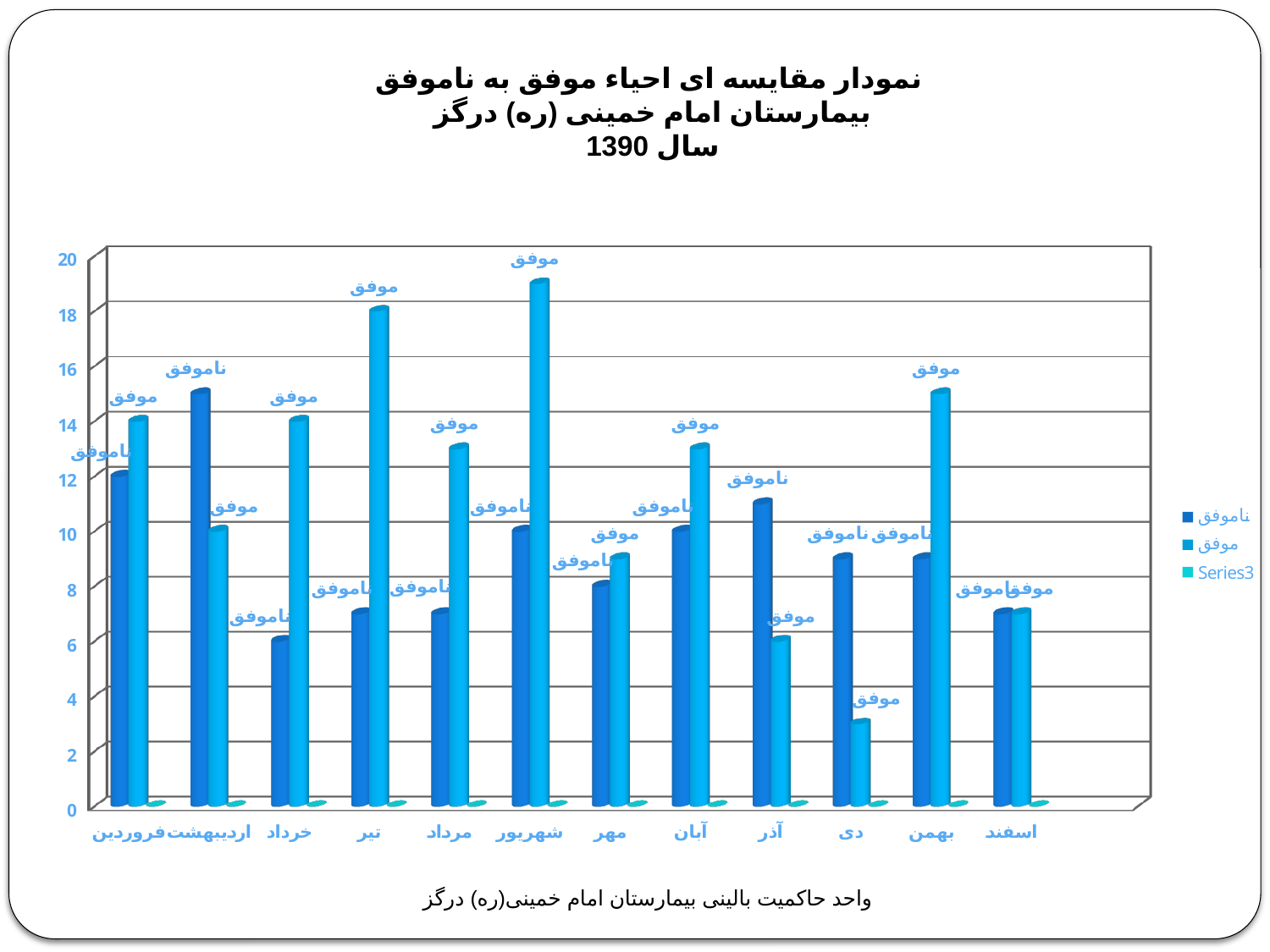
Is the ناموفق value for اردیبهشت greater or less than 14? greater What kind of chart is shown on the slide? bar chart How many series does the legend list? 3 Is the موفق value for شهریور greater or less than 18? greater Which month has the highest value for the ناموفق series? اردیبهشت In آذر, which series has the larger value, موفق or ناموفق? ناموفق How many months (categories) are shown along the x axis? 12 In تیر, which series has the larger value, موفق or ناموفق? موفق Which month has the lowest value for the موفق series? دی Is the موفق value for دی greater or less than 4? less What is the name of the third entry in the legend? Series3